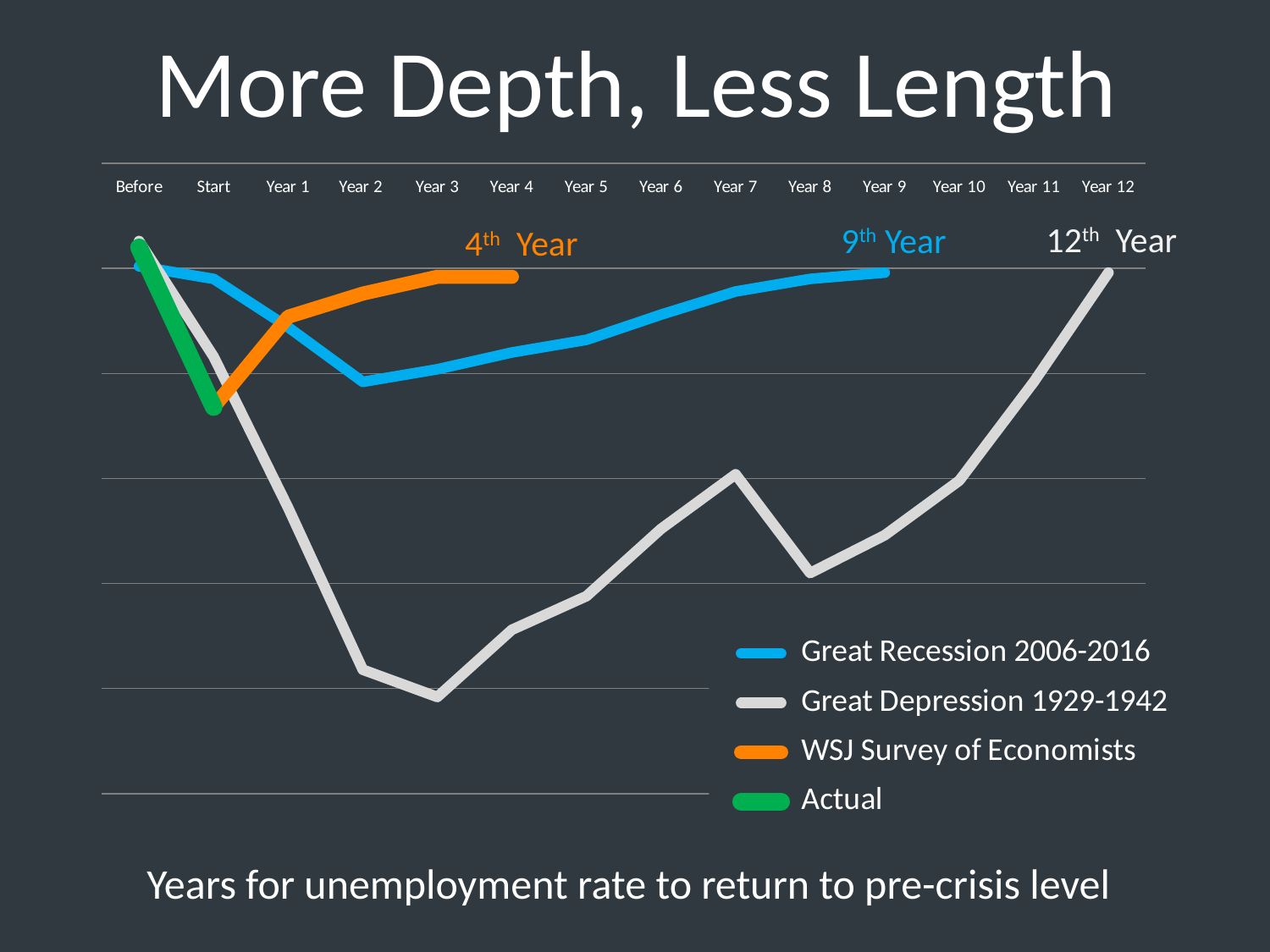
Which line falls further below the pre-crisis level, Great Recession 2006-2016 or Great Depression 1929-1942? Great Depression 1929-1942 How many categories are labelled along the x axis? 14 What colour is the Actual line in the legend? Green How many series does the legend list? 4 According to the annotation, in which year does the Great Depression 1929-1942 line return to the pre-crisis level? 12th Year Which series drops to the lowest point on the chart? Great Depression 1929-1942 Which series takes the longest to return to the pre-crisis level? Great Depression 1929-1942 According to the annotation, in which year does the WSJ Survey of Economists line return to the pre-crisis level? 4th Year What kind of chart is shown on the slide? Line chart Which series returns to the pre-crisis level the fastest? WSJ Survey of Economists Does the Great Depression 1929-1942 line rise or fall between Year 3 and Year 7? Rise According to the annotation, in which year does the Great Recession 2006-2016 line return to the pre-crisis level? 9th Year